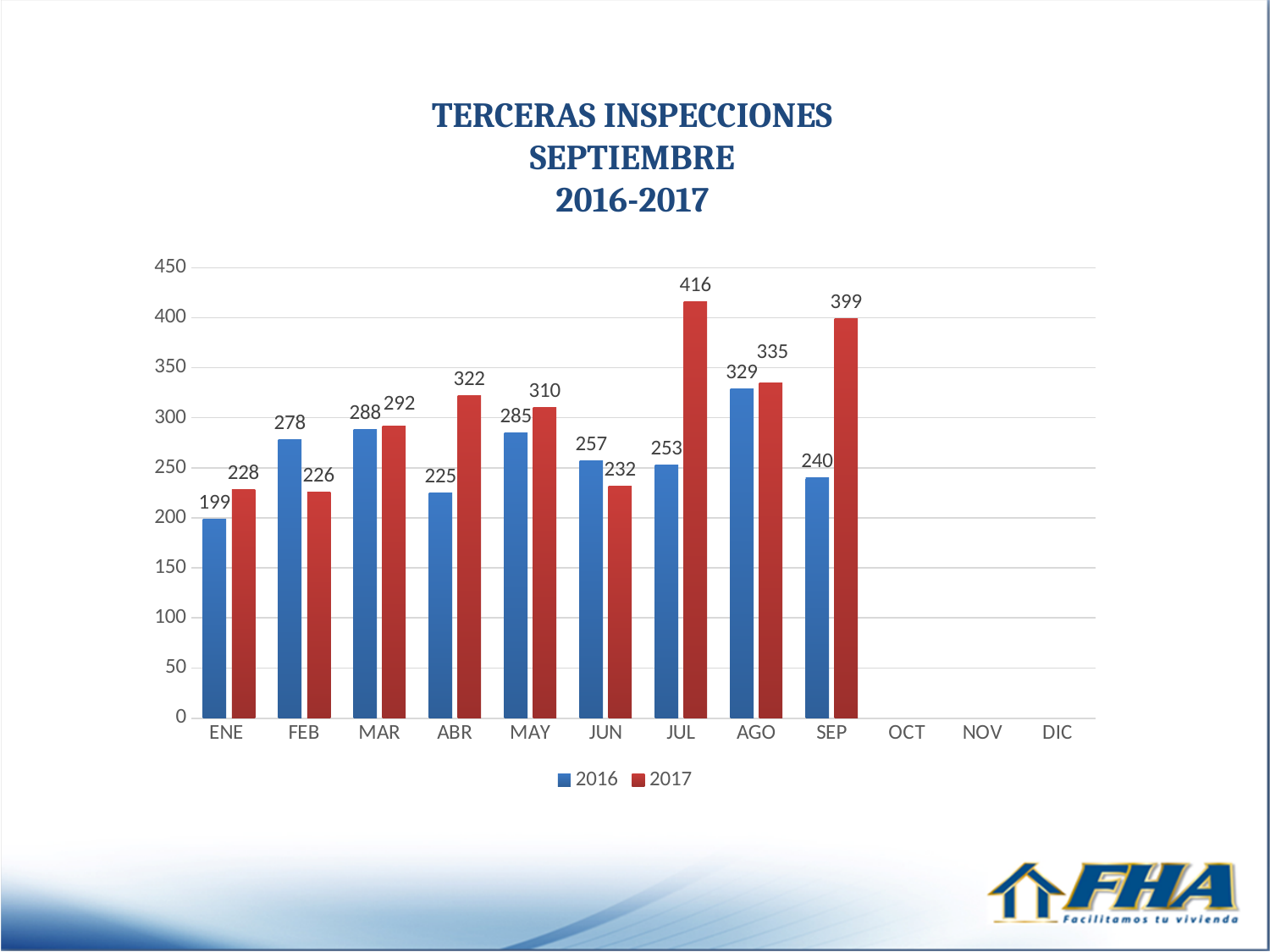
What is the difference between the 2017 and 2016 values in JUL? 163 Which month has the highest value for the 2017 series? JUL What is the value for 2016 in AGO? 329 In ABR, which series has the larger value, 2016 or 2017? 2017 What is the value for 2016 in ENE? 199 What is the value for 2017 in SEP? 399 What kind of chart is shown on the slide? bar chart Which month has the lowest value for the 2016 series? ENE How many months have bars plotted on the chart? 9 What is the value for 2017 in JUL? 416 How many series does the legend list? 2 Is the value for 2016 in FEB greater or less than 250? greater